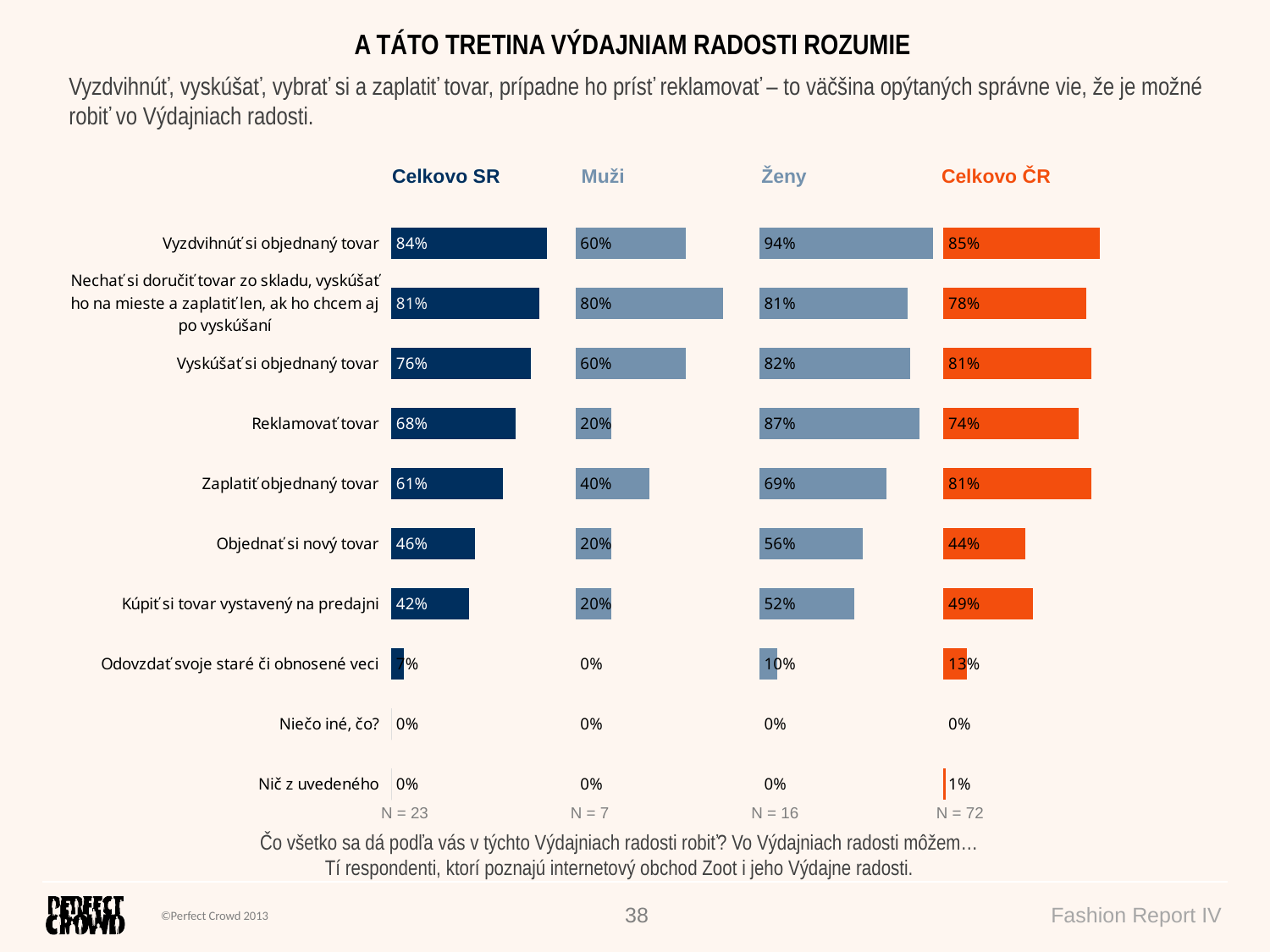
In the Celkovo SR chart, what is the difference between "Vyzdvihnúť si objednaný tovar" and "Reklamovať tovar"? 16% In the Ženy chart, what is the value for "Zaplatiť objednaný tovar"? 69% What kind of chart is the Muži chart? Bar chart How many categories are shown in the Celkovo SR chart? 10 In the Muži chart, what is the value for "Reklamovať tovar"? 20% In the Celkovo ČR chart, what is the value for "Kúpiť si tovar vystavený na predajni"? 49% What is the sample size (N) shown under the Celkovo ČR chart? N = 72 In the Celkovo ČR chart, which category has the lowest non-zero value? Nič z uvedeného Which is larger: "Reklamovať tovar" in the Muži chart or "Reklamovať tovar" in the Ženy chart? Ženy In the Ženy chart, which category has the highest value? Vyzdvihnúť si objednaný tovar In the Ženy chart, what is the difference between "Reklamovať tovar" and "Objednať si nový tovar"? 31% In the Celkovo SR chart, what is the value for "Vyzdvihnúť si objednaný tovar"? 84%